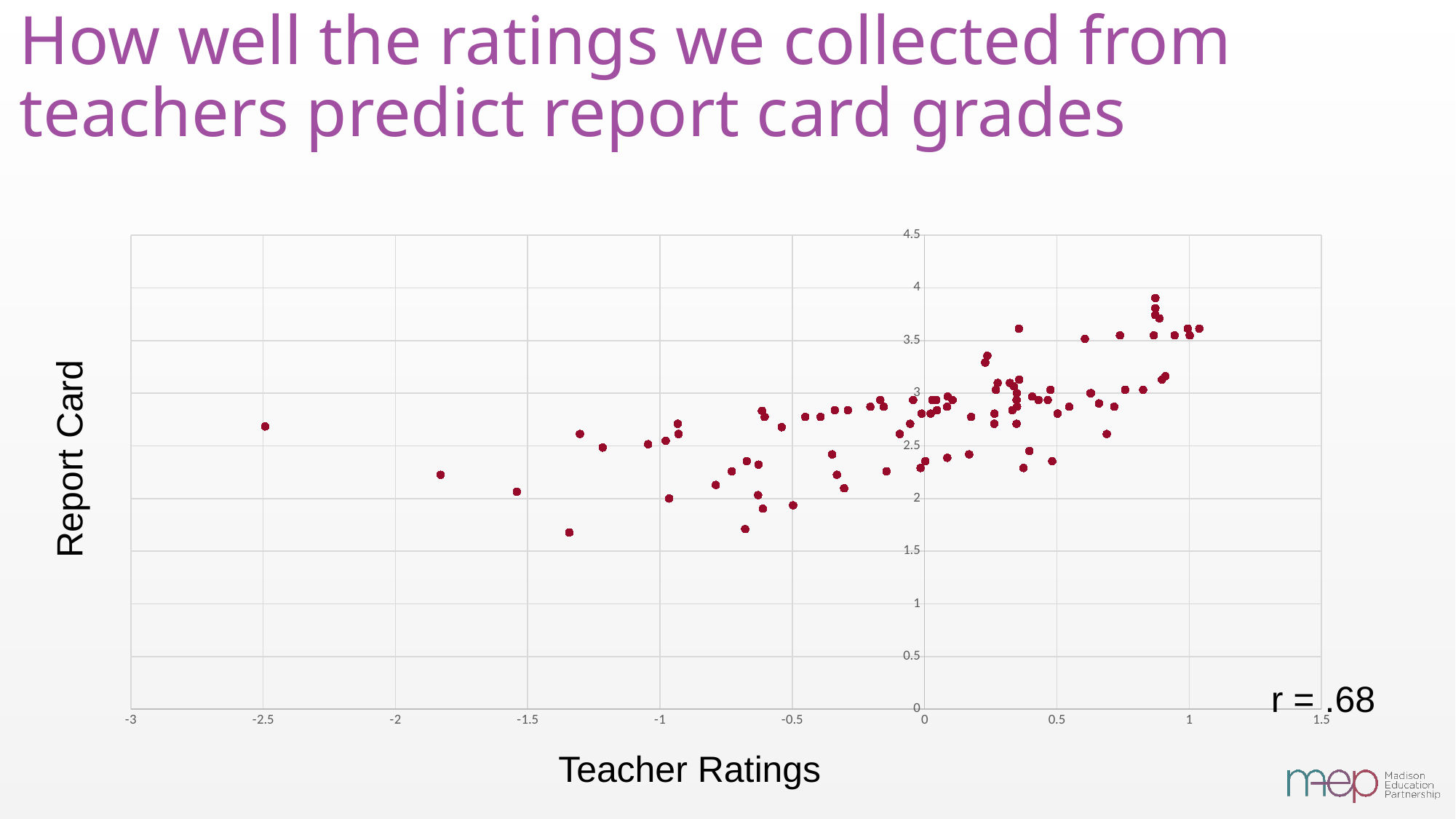
Is the lowest Report Card value plotted on the chart greater or less than 1.5? greater What is the maximum value shown on the y axis of the chart? 4.5 Is the highest Report Card value plotted on the chart greater or less than 3.5? greater What is the label of the x axis of the chart? Teacher Ratings What is the label of the y axis of the chart? Report Card As Teacher Ratings increase along the x axis, do Report Card values generally rise or fall? rise Is the Report Card value of the point with the lowest Teacher Rating (near -2.5) greater or less than 2.5? greater What kind of chart is shown on the slide? scatter plot